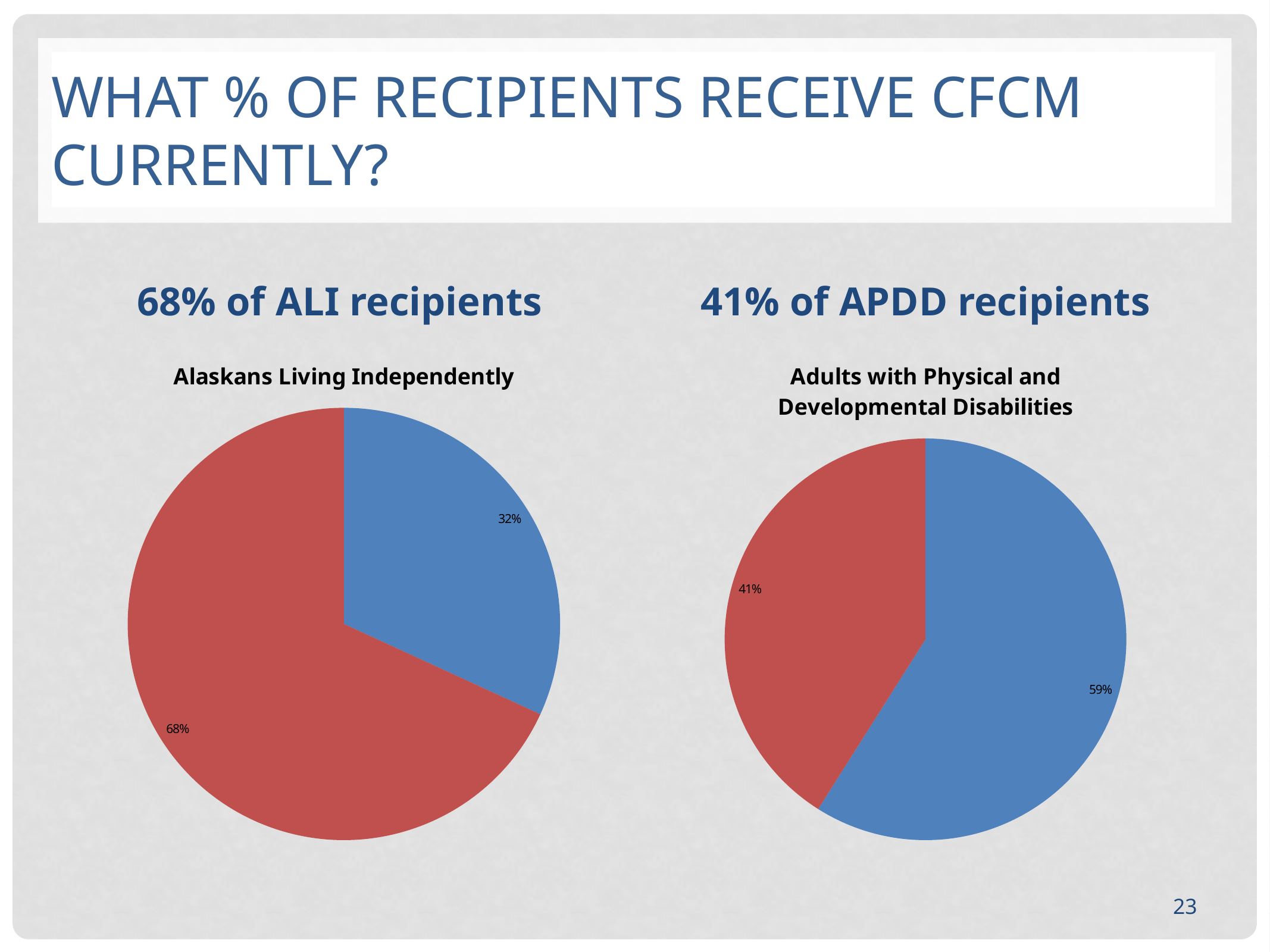
In the 'Alaskans Living Independently' pie chart, what percentage is shown on the blue slice? 32% In the 'Adults with Physical and Developmental Disabilities' pie chart, what percentage is shown on the blue slice? 59% In the 'Adults with Physical and Developmental Disabilities' pie chart, what percentage is shown on the red slice? 41% In the 'Alaskans Living Independently' pie chart, which slice is larger, the red or the blue? red What kind of chart is the 'Alaskans Living Independently' chart? pie chart In the 'Adults with Physical and Developmental Disabilities' pie chart, which slice is larger, the red or the blue? blue In the 'Alaskans Living Independently' pie chart, what percentage is shown on the red slice? 68% What is the title of the pie chart on the right side of the slide? Adults with Physical and Developmental Disabilities In the 'Alaskans Living Independently' pie chart, what is the difference between the red slice and the blue slice? 36% How many pie charts are shown on the slide? 2 In the 'Adults with Physical and Developmental Disabilities' pie chart, what is the difference between the blue slice and the red slice? 18% How many slices does the 'Alaskans Living Independently' pie chart have? 2